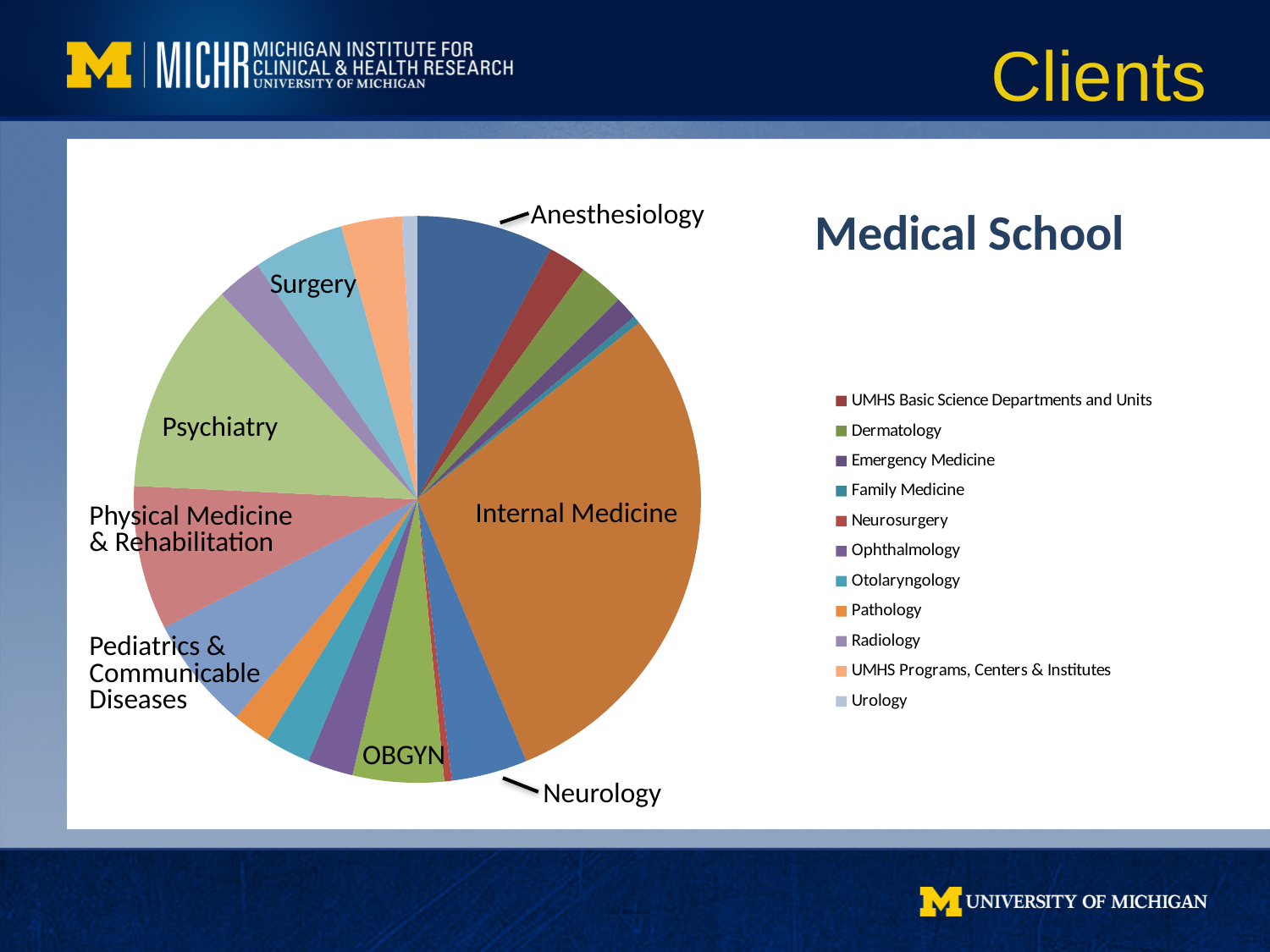
How many entries does the legend list? 11 Which slice is larger, Internal Medicine or Pediatrics & Communicable Diseases? Internal Medicine Which legend entry is listed last? Urology What kind of chart is shown on the slide? pie chart Which slice is larger, Physical Medicine & Rehabilitation or Surgery? Physical Medicine & Rehabilitation Which category has the largest slice of the pie? Internal Medicine Which slice is larger, Psychiatry or Physical Medicine & Rehabilitation? Psychiatry How many slices are labeled directly on the pie? 8 What is the title shown next to the pie chart? Medical School